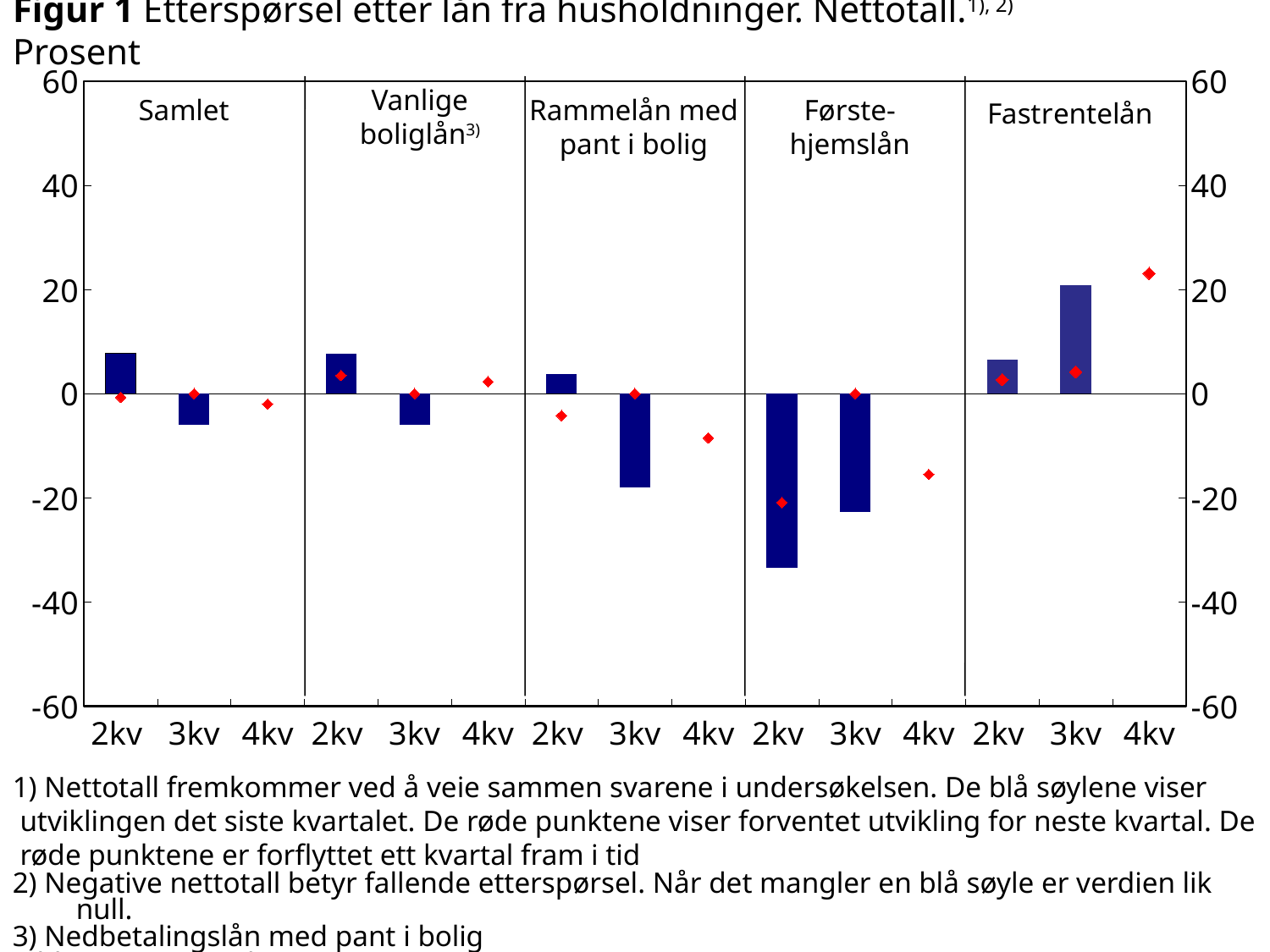
Is the value of the red point for 4kv in the Fastrentelån panel greater or less than 20? greater Which panel contains the lowest blue bar in the chart? Førstehjemslån How many quarters are shown on the x axis within each panel? 3 What kind of chart is shown in Figur 1? bar chart Is the value of the blue bar for 3kv in the Fastrentelån panel greater or less than 10? greater Is the value of the blue bar for 2kv in the Samlet panel greater or less than 20? less How many loan-type panels does the chart have? 5 According to footnote 1, what do the red points show? Forventet utvikling for neste kvartal Which panel contains the highest blue bar in the chart? Fastrentelån In the Førstehjemslån panel, which quarter has the lower blue bar, 2kv or 3kv? 2kv